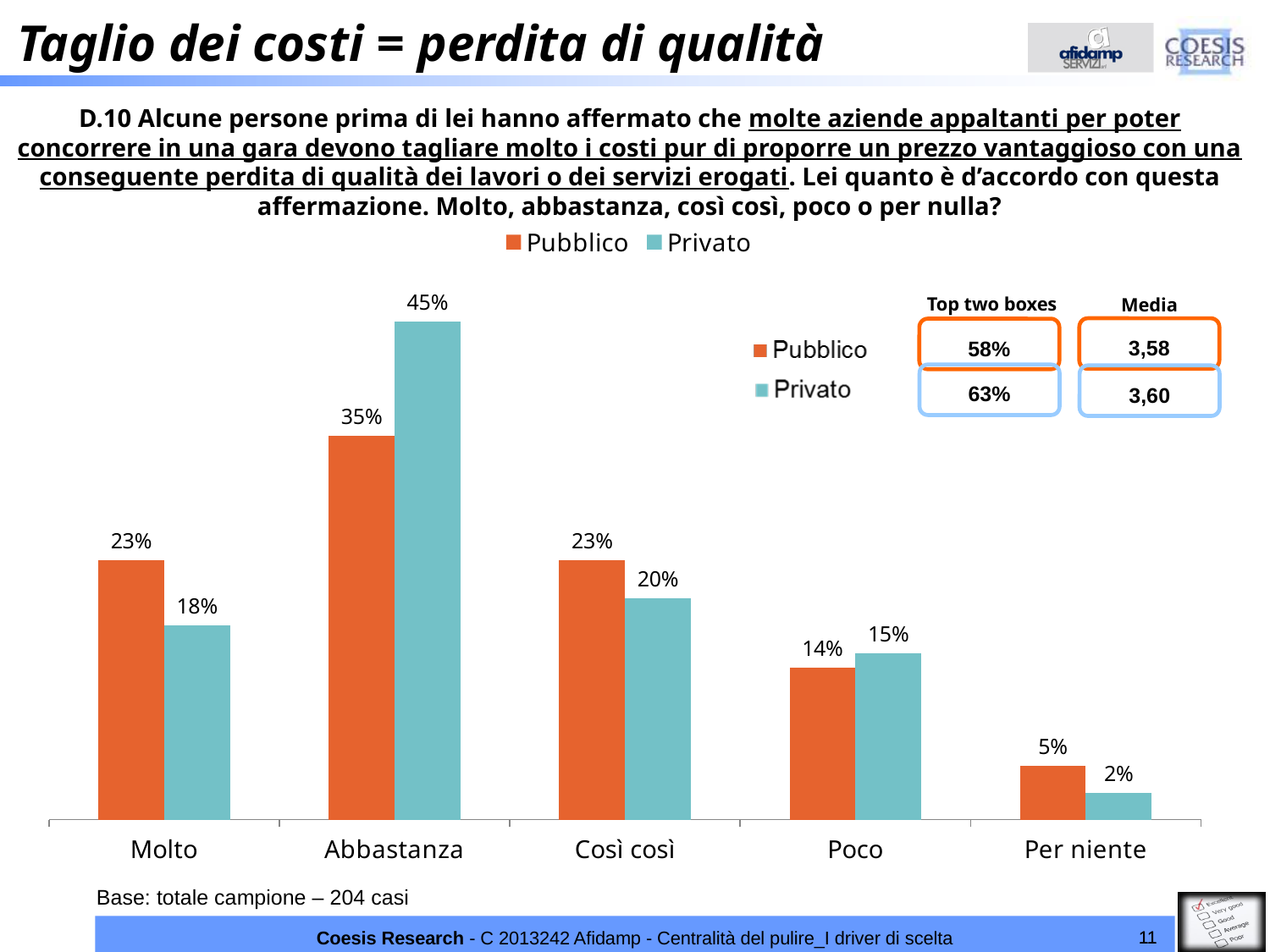
Which category has the lowest value for the Pubblico series? Per niente What is the value for Pubblico in the Abbastanza category? 35% What is the Top two boxes value shown for Privato? 63% What kind of chart is shown on the slide? Bar chart In the Poco category, which series has the larger value, Pubblico or Privato? Privato In the Così così category, which series has the larger value, Pubblico or Privato? Pubblico What is the difference between Privato and Pubblico in the Abbastanza category? 10% What is the value for Privato in the Per niente category? 2% Which category has the highest value for the Privato series? Abbastanza What is the value for Privato in the Molto category? 18% How many series does the legend list? 2 How many categories are shown on the x axis? 5